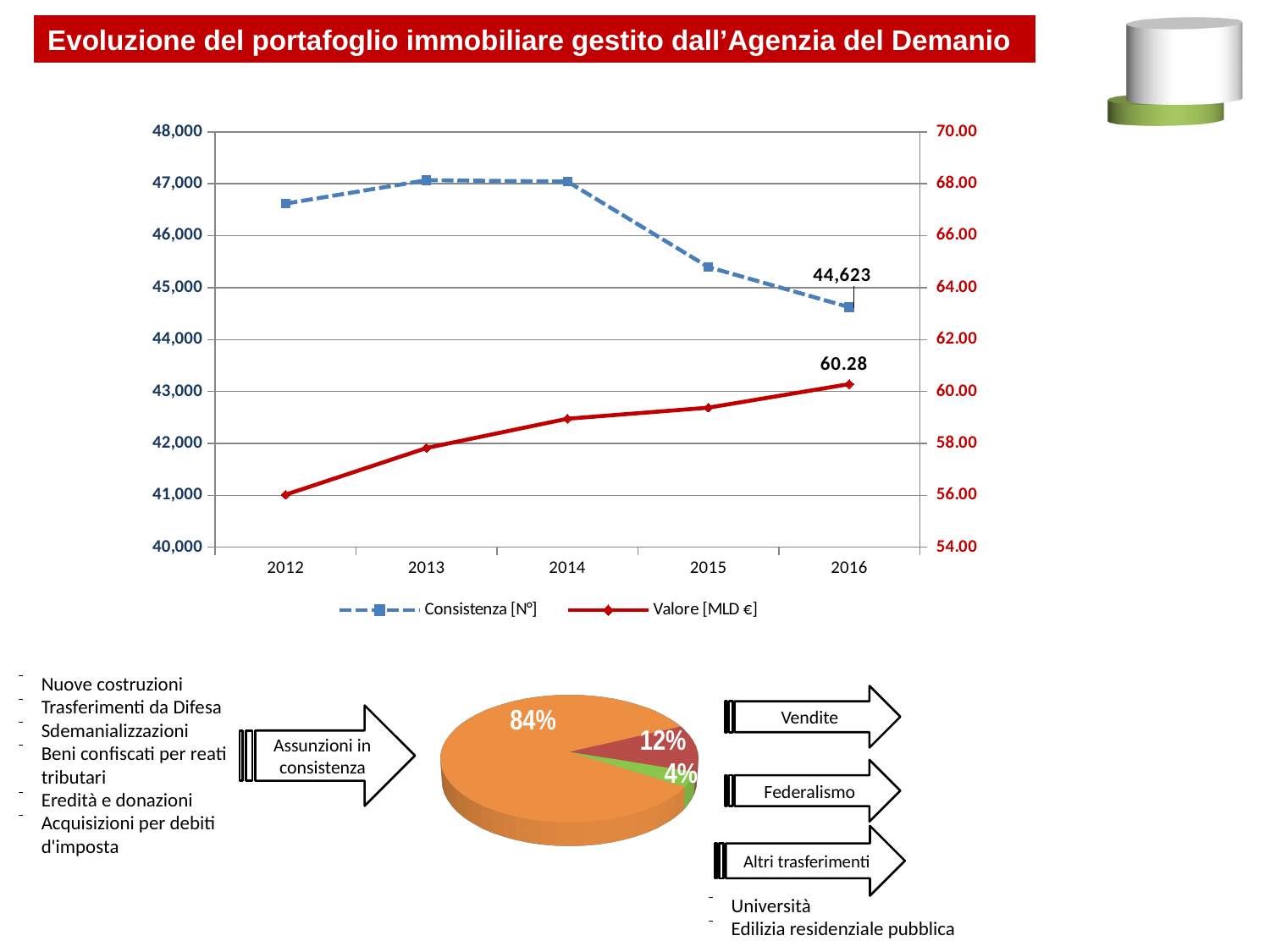
In the line chart, does Valore [MLD €] rise or fall from 2012 to 2016? Rise In the line chart, is the value of Valore [MLD €] in 2012 greater or less than 58.00? less What kind of chart is the top chart on the slide? Line chart In the line chart, does Consistenza [N°] rise or fall from 2014 to 2016? Fall In the line chart, which year has the lowest value of Consistenza [N°]? 2016 How many years are shown on the x axis of the line chart? 5 In the line chart, is the value of Consistenza [N°] in 2012 greater or less than 46,000? greater In the line chart, what is the value of Consistenza [N°] in 2016? 44,623 How many slices does the pie chart at the bottom of the slide have? 3 In the pie chart at the bottom of the slide, what is the share of the largest slice? 84% How many series does the legend of the line chart list? 2 In the line chart, what is the value of Valore [MLD €] in 2016? 60.28